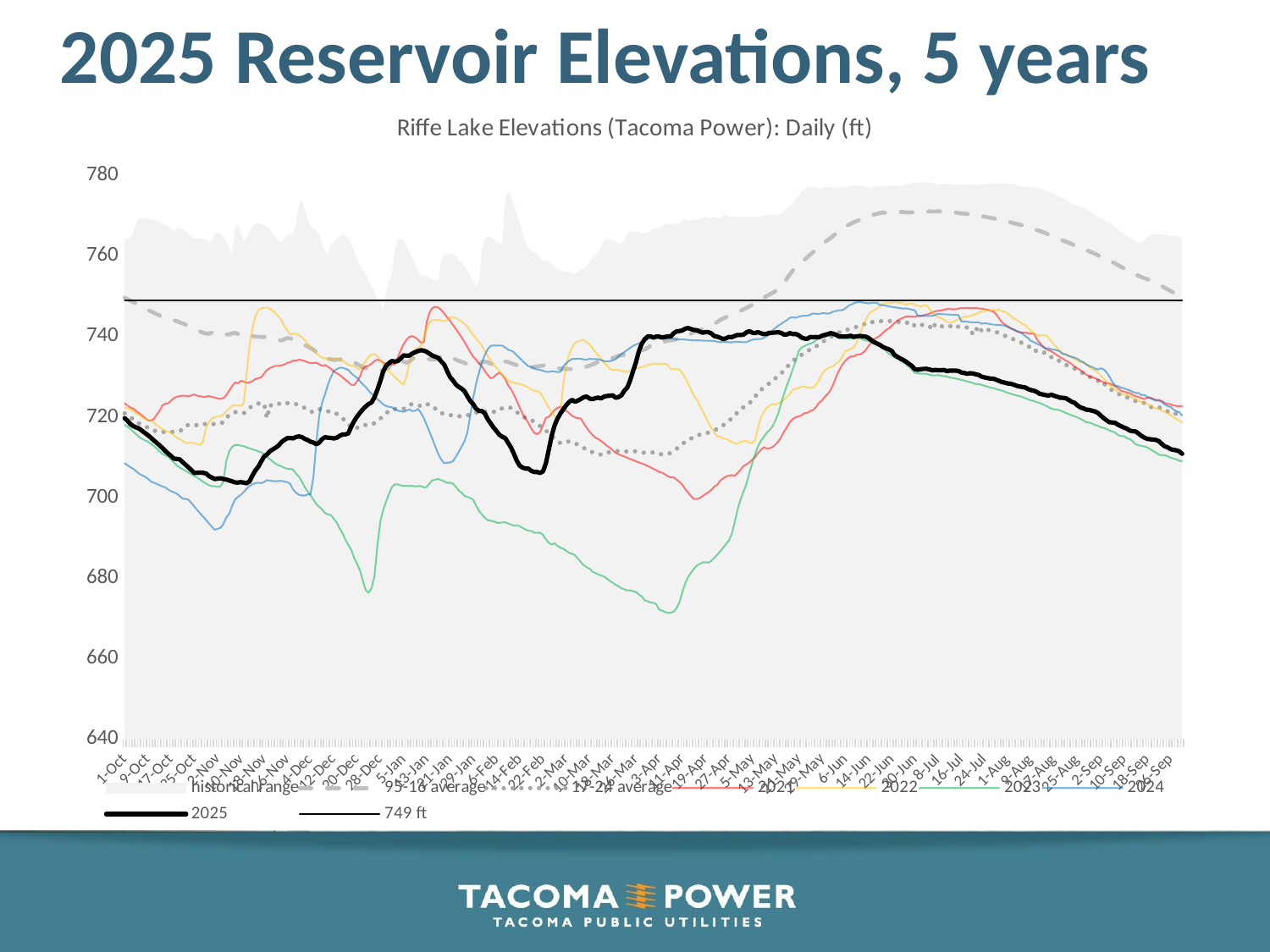
What is the title of the chart? Riffe Lake Elevations (Tacoma Power): Daily (ft) Is the value of the 2025 line at 26-Sep greater or less than 720? less Is the highest point of the 95-16 average line greater or less than 760? greater What type of chart is shown on the slide? line chart Does the 2025 line rise or fall from mid-June to the end of September? fall How many entries does the chart legend list? 9 Which series is drawn as the thick black line? 2025 At the end of the chart in late September, is the 2025 line higher or lower than the 2021 line? lower Which series reaches the lowest elevation on the chart? 2023 What elevation does the thin horizontal reference line in the legend represent? 749 ft Is the lowest point of the 2023 line greater or less than 680? less